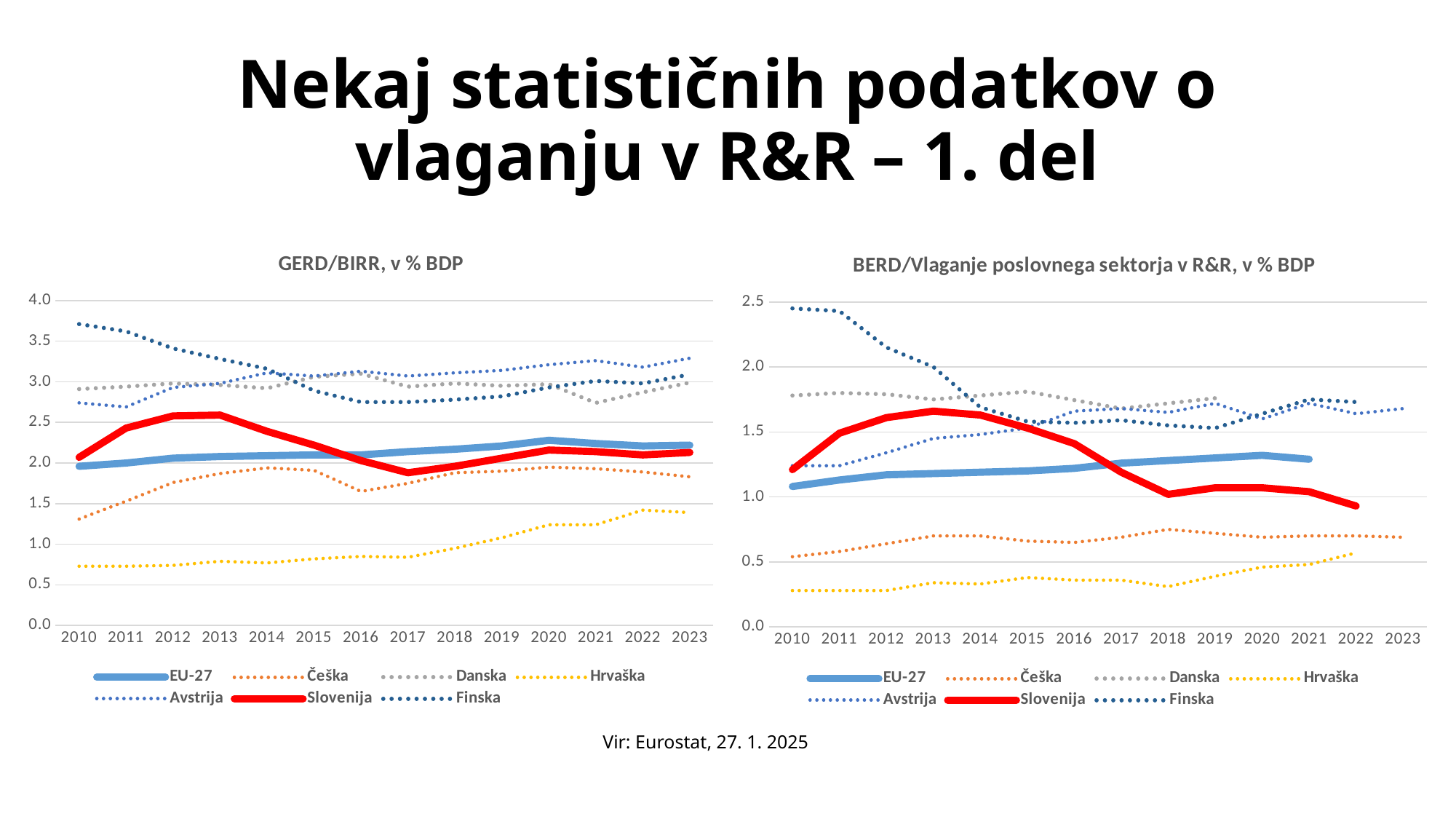
What is the title of the chart on the right? BERD/Vlaganje poslovnega sektorja v R&R, v % BDP In the BERD chart on the right, is the value for Finska in 2010 greater or less than 2.0? greater In the GERD/BIRR chart on the left, does the Finska line rise or fall from 2010 to 2017? fall In the GERD/BIRR chart on the left, which series has the highest value in 2010? Finska How many years are shown on the x axis of the GERD/BIRR chart on the left? 14 In the BERD chart on the right, is the value for Hrvaška in 2018 greater or less than 0.5? less How many series does the legend of the BERD chart on the right list? 7 What kind of chart is the GERD/BIRR chart on the left? line chart In the GERD/BIRR chart on the left, is the value for Hrvaška in 2010 greater or less than 1.0? less In the BERD chart on the right, which series has the lowest value in 2010? Hrvaška In the BERD chart on the right, which is larger in 2022: Slovenija or Češka? Slovenija